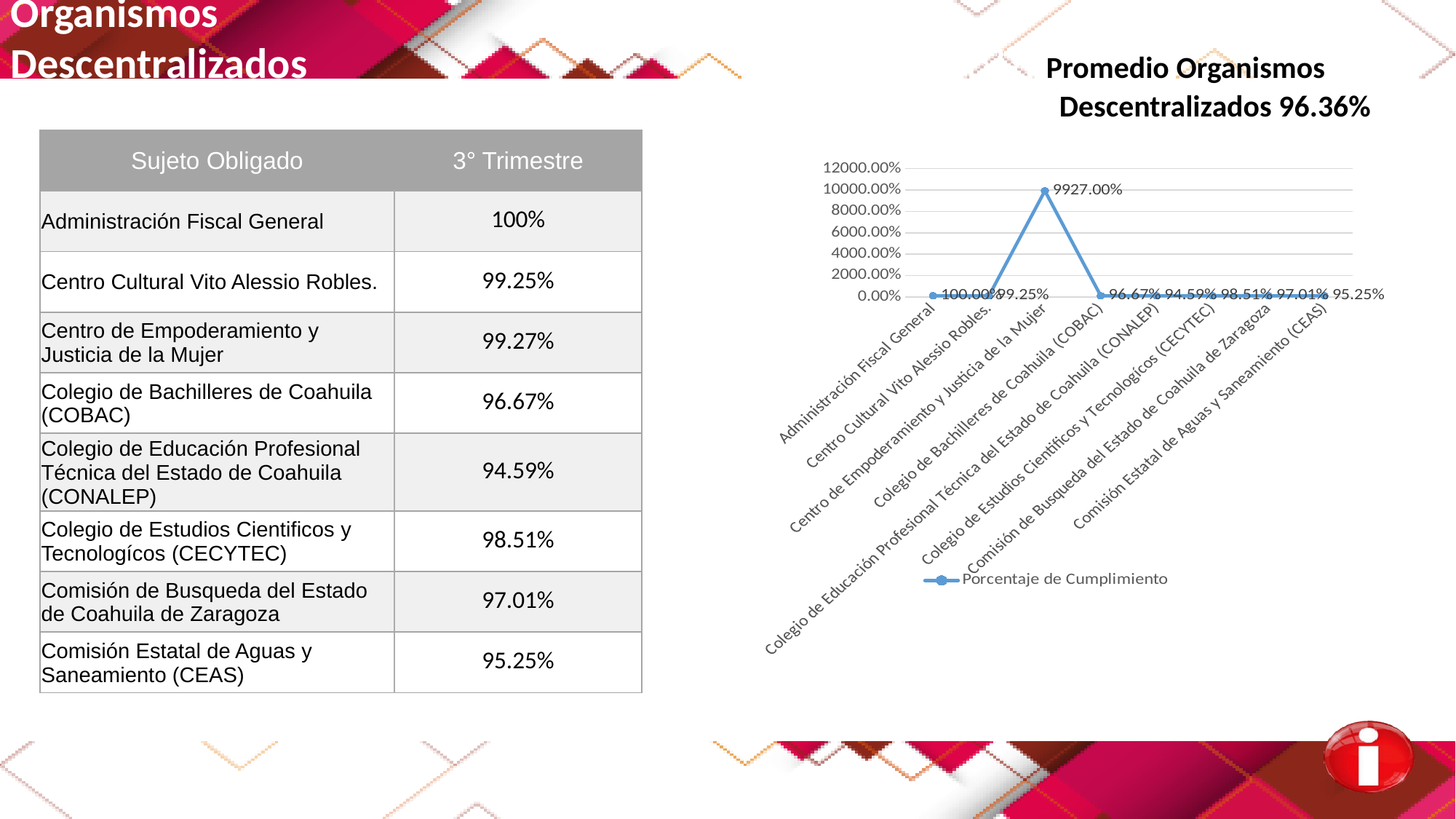
What kind of chart is shown on the slide? line chart How many categories are plotted on the chart's x axis? 8 What value does the chart show for Colegio de Bachilleres de Coahuila (COBAC)? 96.67% Is the chart value for Centro de Empoderamiento y Justicia de la Mujer greater or less than 8000.00%? greater What is the name of the series in the chart legend? Porcentaje de Cumplimiento What value does the chart show for Administración Fiscal General? 100.00% Which category has the lowest value on the chart? Colegio de Educación Profesional Técnica del Estado de Coahuila (CONALEP) What value does the chart show for Comisión Estatal de Aguas y Saneamiento (CEAS)? 95.25% What value does the chart show for Centro de Empoderamiento y Justicia de la Mujer? 9927.00% How many series does the chart legend list? 1 Which category has the highest value on the chart? Centro de Empoderamiento y Justicia de la Mujer What is the difference between the chart values for Colegio de Estudios Científicos y Tecnológicos (CECYTEC) and Comisión de Busqueda del Estado de Coahuila de Zaragoza? 1.50%